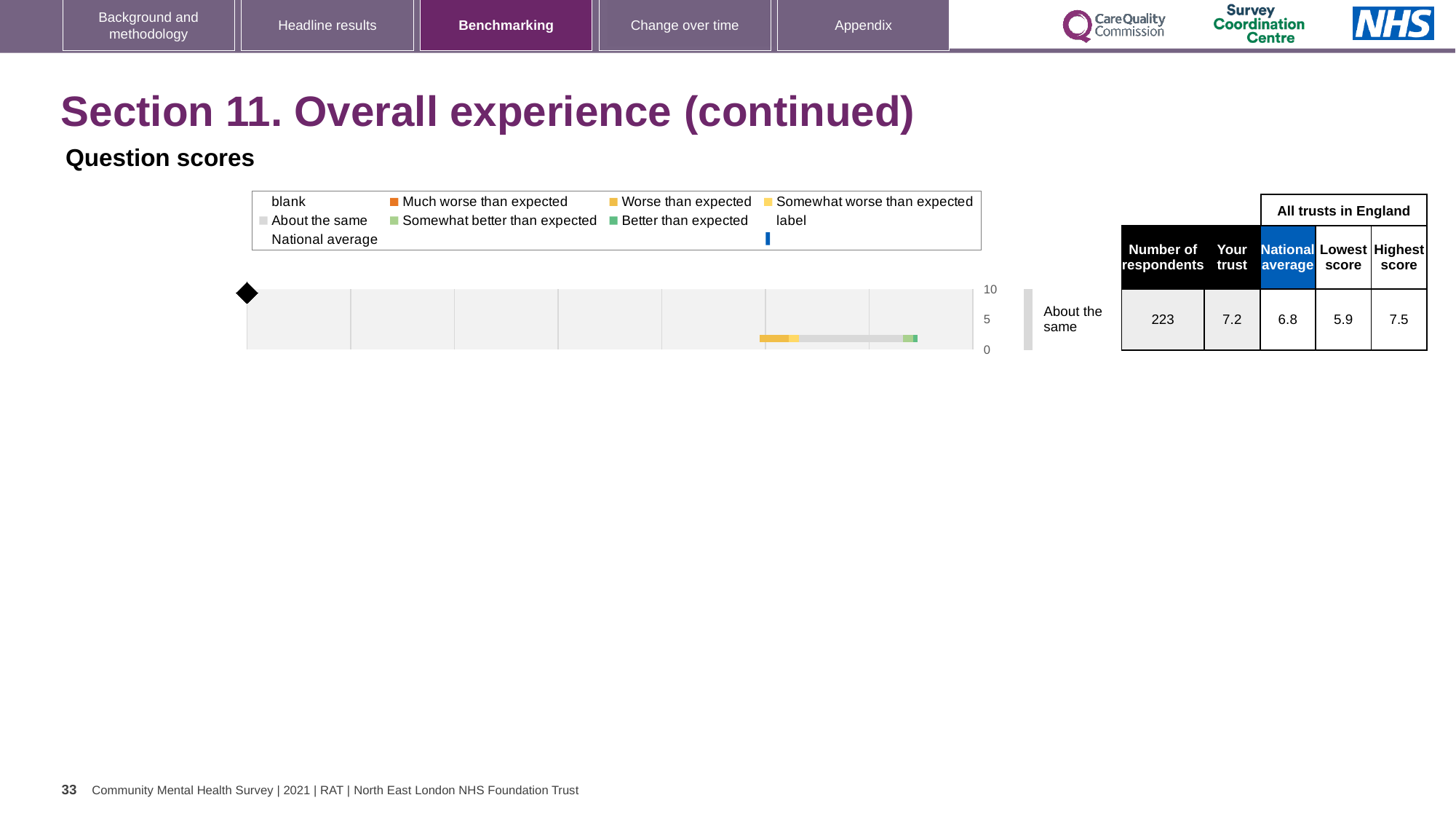
Which legend entry is shown in orange? Much worse than expected In the table next to the chart, what is the National average score? 6.8 What kind of chart is shown under 'Question scores'? bar chart Which is larger, the 'Your trust' score or the National average score? Your trust In the table next to the chart, what is the Highest score among all trusts in England? 7.5 In the table next to the chart, what is the Lowest score among all trusts in England? 5.9 In the table next to the chart, what is the 'Your trust' score for the 'About the same' row? 7.2 How many question bars are plotted in the chart? 1 What is the label of the single row plotted in the chart? About the same How many respondents are listed for the 'About the same' row? 223 What is the highest value shown on the chart's axis? 10